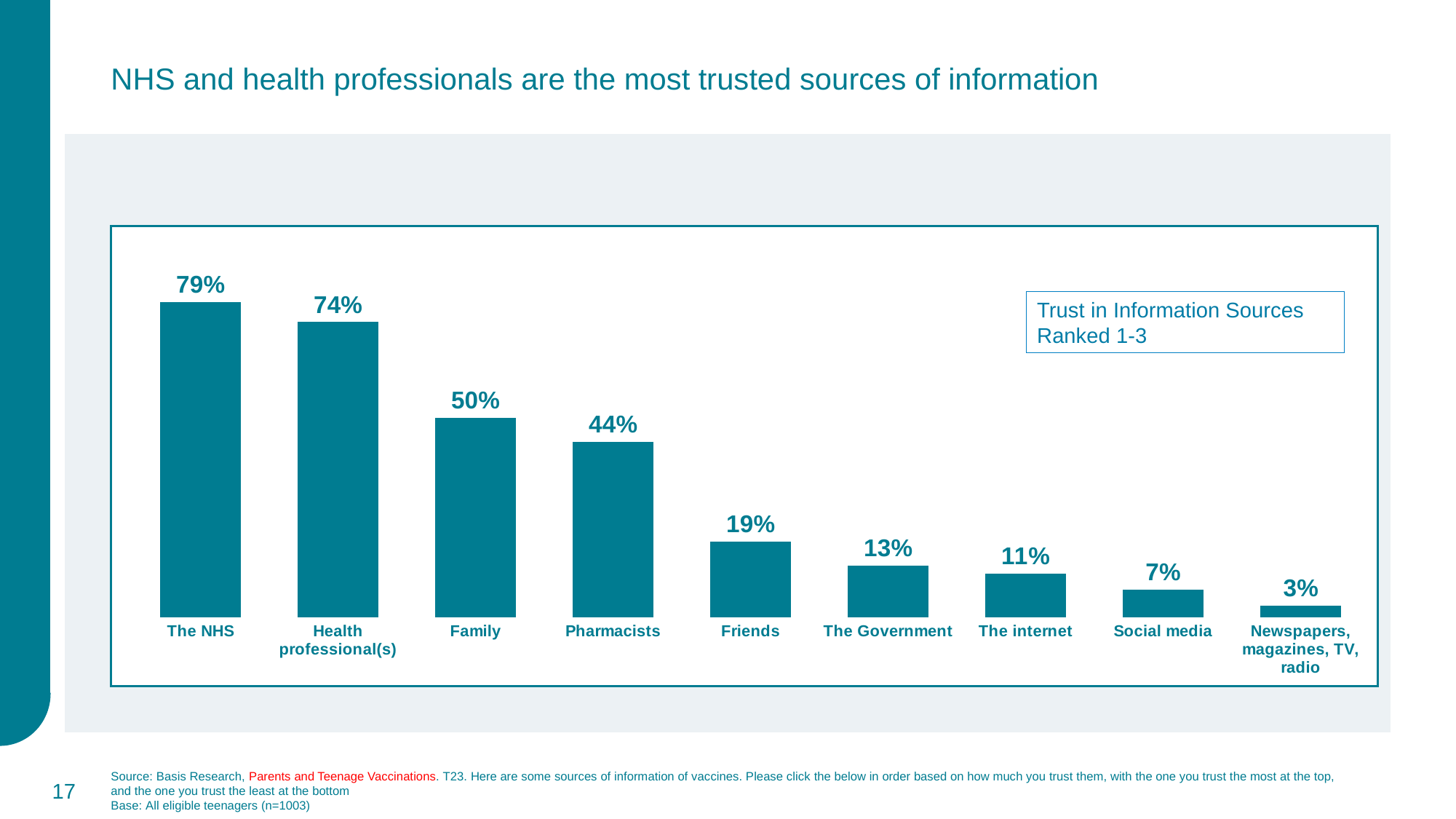
What is the difference between the values for The NHS and Health professional(s)? 5% What is the value shown for Social media? 7% Which information source has the lowest value in the chart? Newspapers, magazines, TV, radio What is the difference between the values for Family and Friends? 31% Which has a higher value, The Government or The internet? The Government Do the values rise or fall moving from left to right across the chart? Fall What is the value shown for Pharmacists? 44% What type of chart is shown on the slide? Bar chart What percentage of teenagers ranked The NHS in their top 3 trusted information sources? 79% How many information sources are shown in the chart? 9 Which information source has the highest value in the chart? The NHS What is the title shown in the box inside the chart? Trust in Information Sources Ranked 1-3